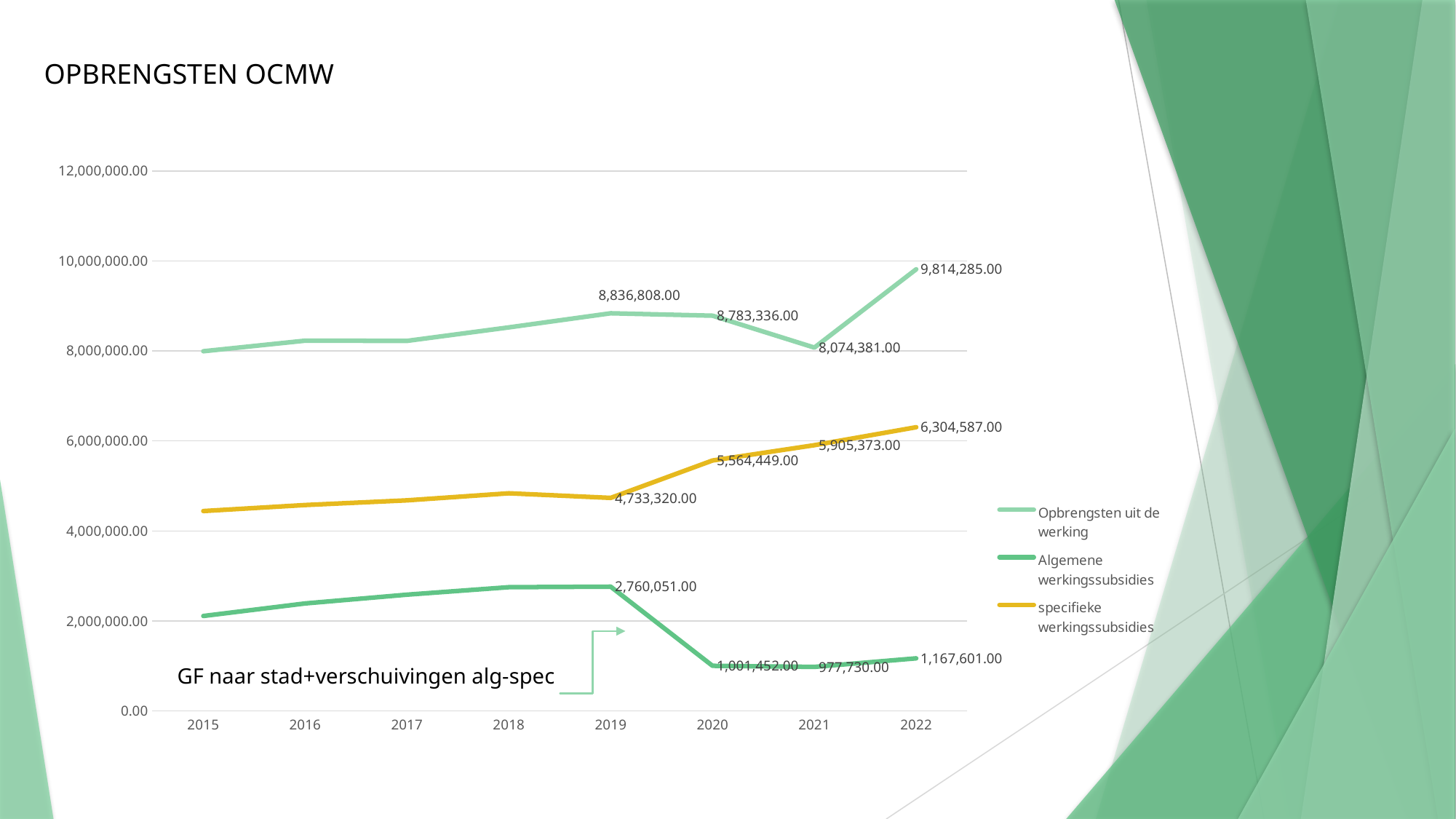
What is the value of Opbrengsten uit de werking in 2022? 9,814,285.00 How many series does the legend list? 3 What is the difference between specifieke werkingssubsidies in 2022 and in 2021? 399,214.00 What is the value of Algemene werkingssubsidies in 2021? 977,730.00 What kind of chart is shown on the slide? line chart In which year is Algemene werkingssubsidies lowest? 2021 Is the value of Algemene werkingssubsidies in 2015 greater or less than 4,000,000.00? less Which is larger in 2020: Opbrengsten uit de werking or specifieke werkingssubsidies? Opbrengsten uit de werking Does specifieke werkingssubsidies rise or fall from 2019 to 2022? rise In which year is Opbrengsten uit de werking highest? 2022 How many years are shown on the x axis? 8 What is the value of specifieke werkingssubsidies in 2020? 5,564,449.00